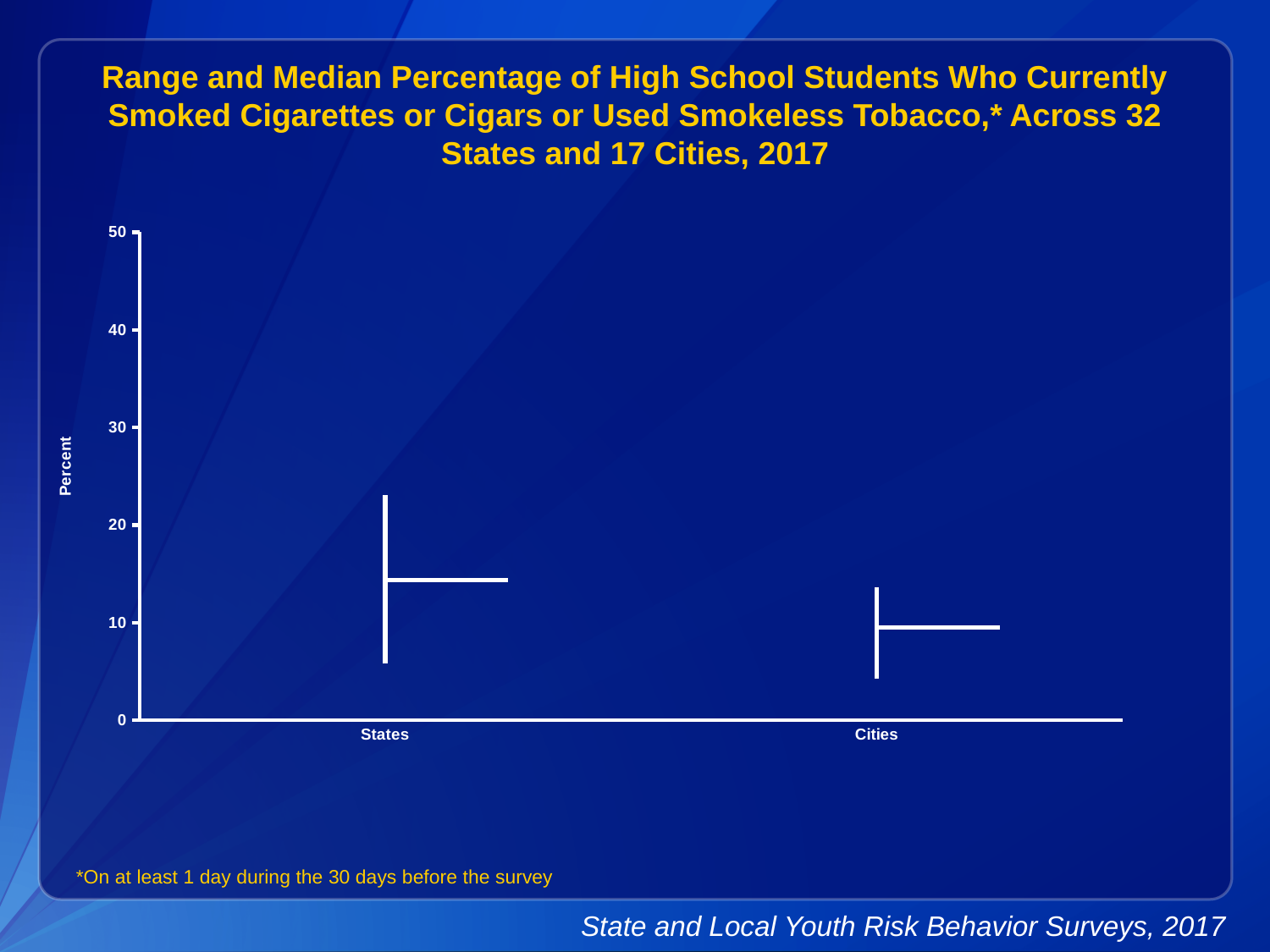
What is the label on the y axis of the chart? Percent Is the bottom of the range for States greater or less than 10? less Is the top of the range for Cities greater or less than 20? less Which category has the higher top of its range, States or Cities? States What are the two categories shown on the x axis? States and Cities Is the median value for States greater or less than 10? greater Which category has the higher median value, States or Cities? States What is the highest value shown on the y axis of the chart? 50 How many categories are shown on the x axis of the chart? 2